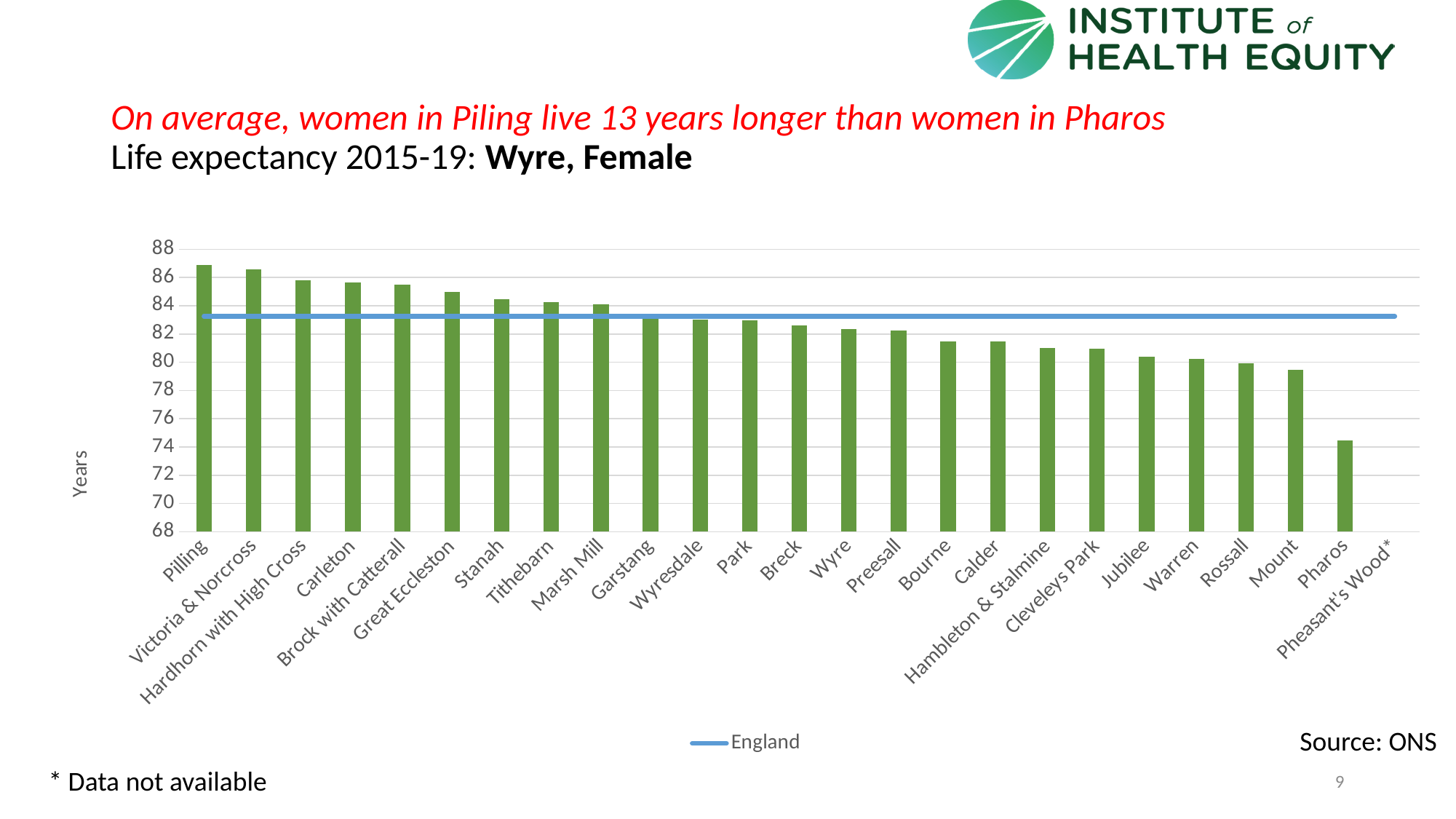
Which ward with a plotted bar has the lowest female life expectancy? Pharos Is the value for Mount greater or less than 80? less How many ward categories are listed on the x axis? 25 Which has the higher female life expectancy, Stanah or Jubilee? Stanah Is the value for Carleton greater or less than 84? greater What kind of chart is shown on the slide? Bar chart Is the value for Pilling greater or less than 86? greater Which ward has the highest female life expectancy in the chart? Pilling Which ward is marked with an asterisk indicating data not available? Pheasant's Wood What does the horizontal blue line in the chart represent, according to the legend? England Do the bar values rise or fall moving from left to right along the x axis? Fall